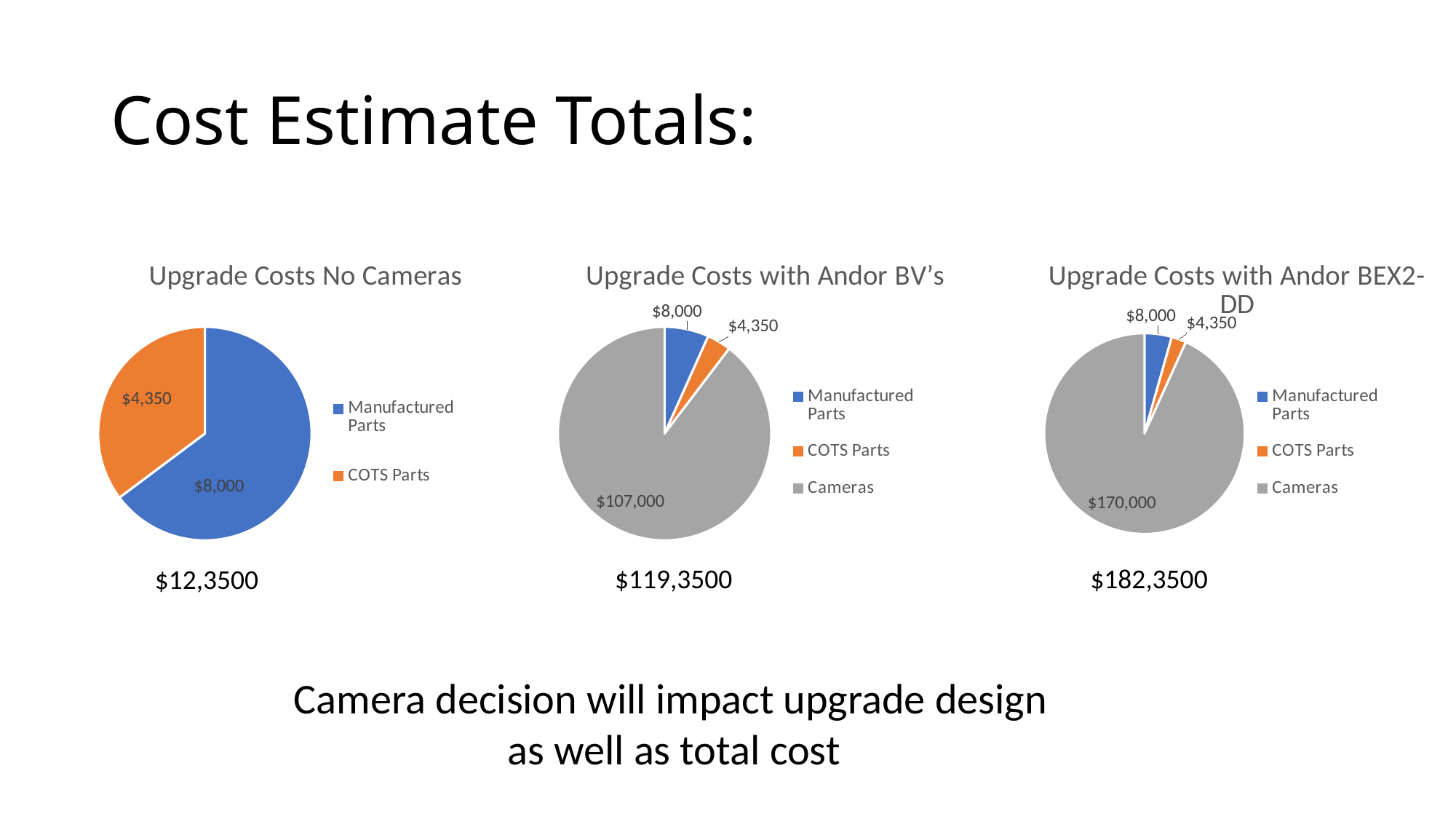
What total cost is printed below the 'Upgrade Costs with Andor BEX2-DD' chart? $182,3500 What is the difference between the Cameras value in the 'Upgrade Costs with Andor BEX2-DD' chart and the Cameras value in the 'Upgrade Costs with Andor BV's' chart? $63,000 In the 'Upgrade Costs with Andor BV's' chart, what is the value for Cameras? $107,000 In the 'Upgrade Costs No Cameras' chart, what is the difference between Manufactured Parts and COTS Parts? $3,650 In the 'Upgrade Costs No Cameras' chart, what is the value for COTS Parts? $4,350 In the 'Upgrade Costs with Andor BEX2-DD' chart, which category has the smallest slice? COTS Parts How many categories does the legend of the 'Upgrade Costs with Andor BV's' chart list? 3 What kind of chart is 'Upgrade Costs No Cameras'? Pie chart In the 'Upgrade Costs No Cameras' chart, which is larger, Manufactured Parts or COTS Parts? Manufactured Parts In the 'Upgrade Costs No Cameras' chart, what is the value for Manufactured Parts? $8,000 In the 'Upgrade Costs with Andor BEX2-DD' chart, what is the value for Cameras? $170,000 In the 'Upgrade Costs with Andor BV's' chart, which category has the largest slice? Cameras